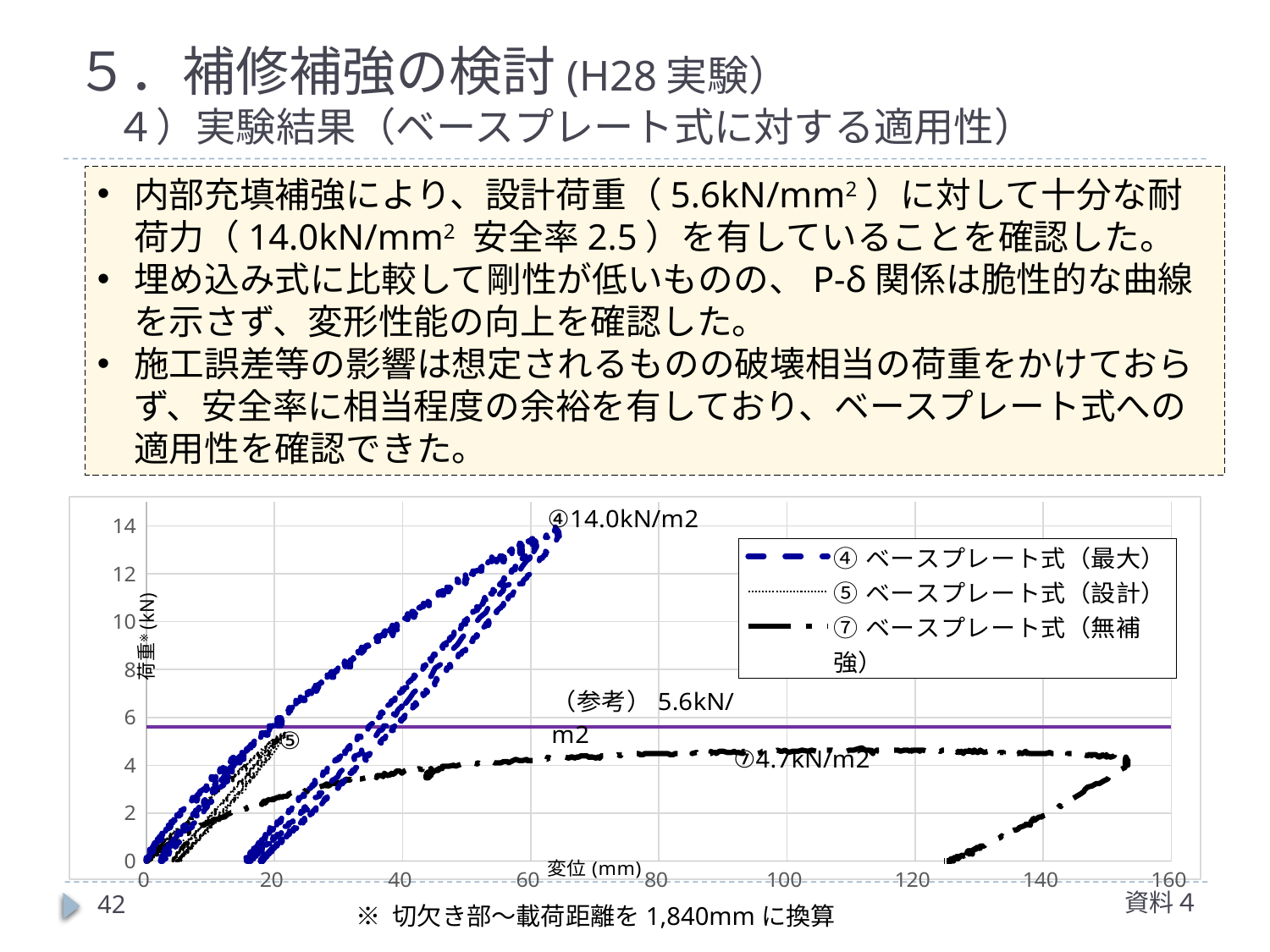
How many series does the chart legend list? 3 What is the load labelled for series ⑦ ベースプレート式（無補強）? 4.7kN/m2 What is the label of the horizontal axis of the chart? 変位 (mm) Which is larger, the labelled load of series ④ or the labelled load of series ⑦? ④ Which series has the lowest peak load in the chart? ⑦ ベースプレート式（無補強） Is the peak load of series ⑦ ベースプレート式（無補強） greater or less than 6 kN? less Which series reaches the highest load in the chart? ④ ベースプレート式（最大） Is the maximum displacement reached by series ⑦ greater or less than 140 mm? greater What load value is marked by the horizontal reference line labelled （参考）? 5.6kN/m2 What is the difference between the labelled load of ④ (14.0kN/m2) and the labelled load of ⑦ (4.7kN/m2)? 9.3kN/m2 What is the peak load labelled for series ④ ベースプレート式（最大）? 14.0kN/m2 What is the label of the vertical axis of the chart? 荷重 (kN)